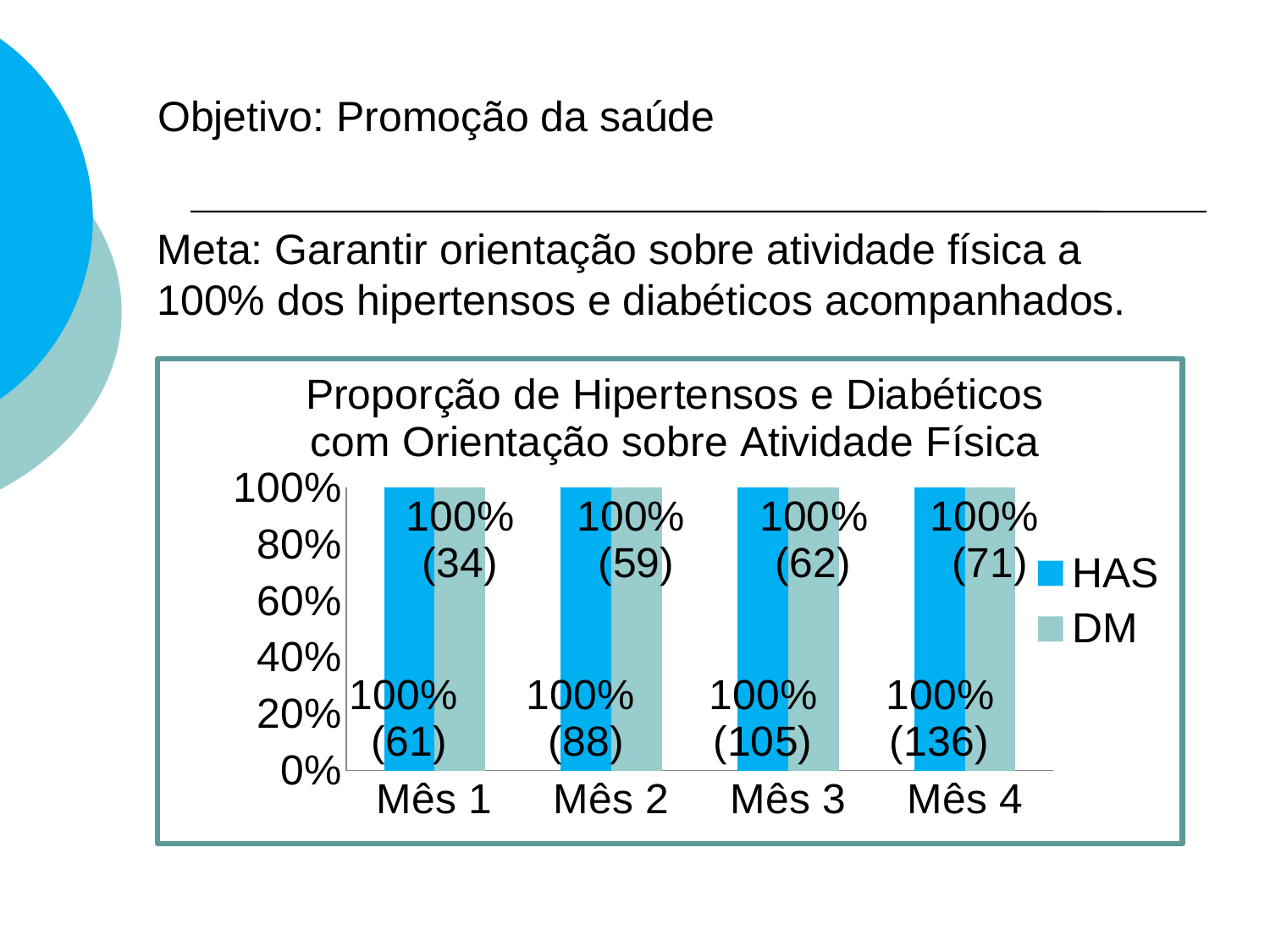
How many months (categories) are shown on the x axis? 4 What is the title of the chart? Proporção de Hipertensos e Diabéticos com Orientação sobre Atividade Física Which series is shown in the darker blue colour? HAS Is the value for DM in Mês 4 greater or less than 80%? greater What percentage is shown for HAS in Mês 3? 100% What is the data label for HAS in Mês 1? 100% (61) What kind of chart is shown on the slide? Bar chart What is the data label for DM in Mês 3? 100% (62) Do the HAS percentages rise, fall, or stay the same from Mês 1 to Mês 4? Stay the same What is the data label for HAS in Mês 4? 100% (136) What is the data label for DM in Mês 2? 100% (59) How many series does the legend list? 2